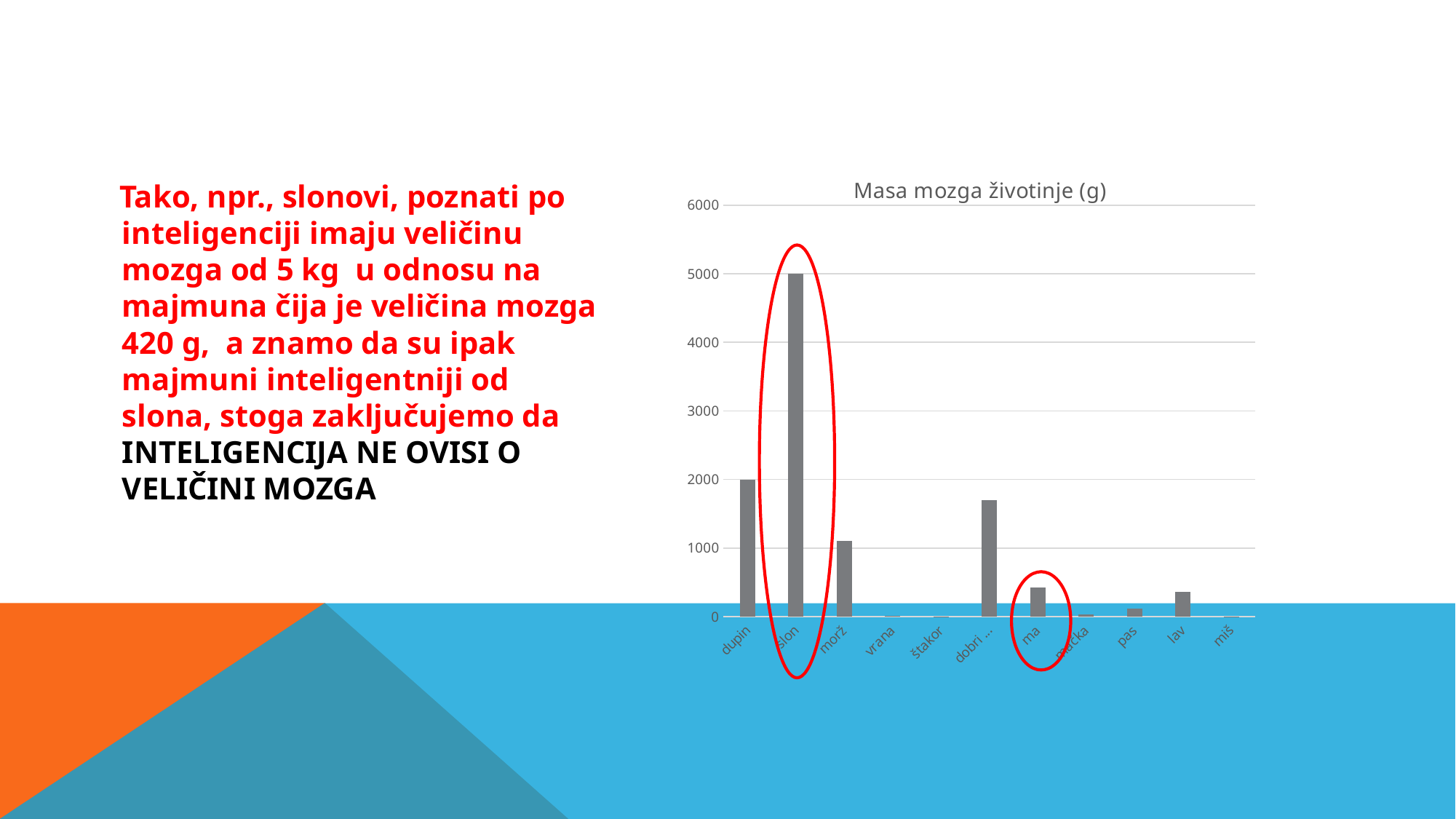
Is the value for pas greater or less than 1000? less What is the title of the chart? Masa mozga životinje (g) How many animal categories are shown on the x axis of the chart? 11 Is the value for dupin greater or less than 1000? greater Is the value for morž greater or less than 1000? greater Which animal has the highest brain mass in the chart? slon Which has a larger value, dupin or morž? dupin What kind of chart is shown on the slide? bar chart What is the brain mass value shown for slon? 5000 Which has a larger value, slon or dupin? slon Which has a larger value, lav or pas? lav